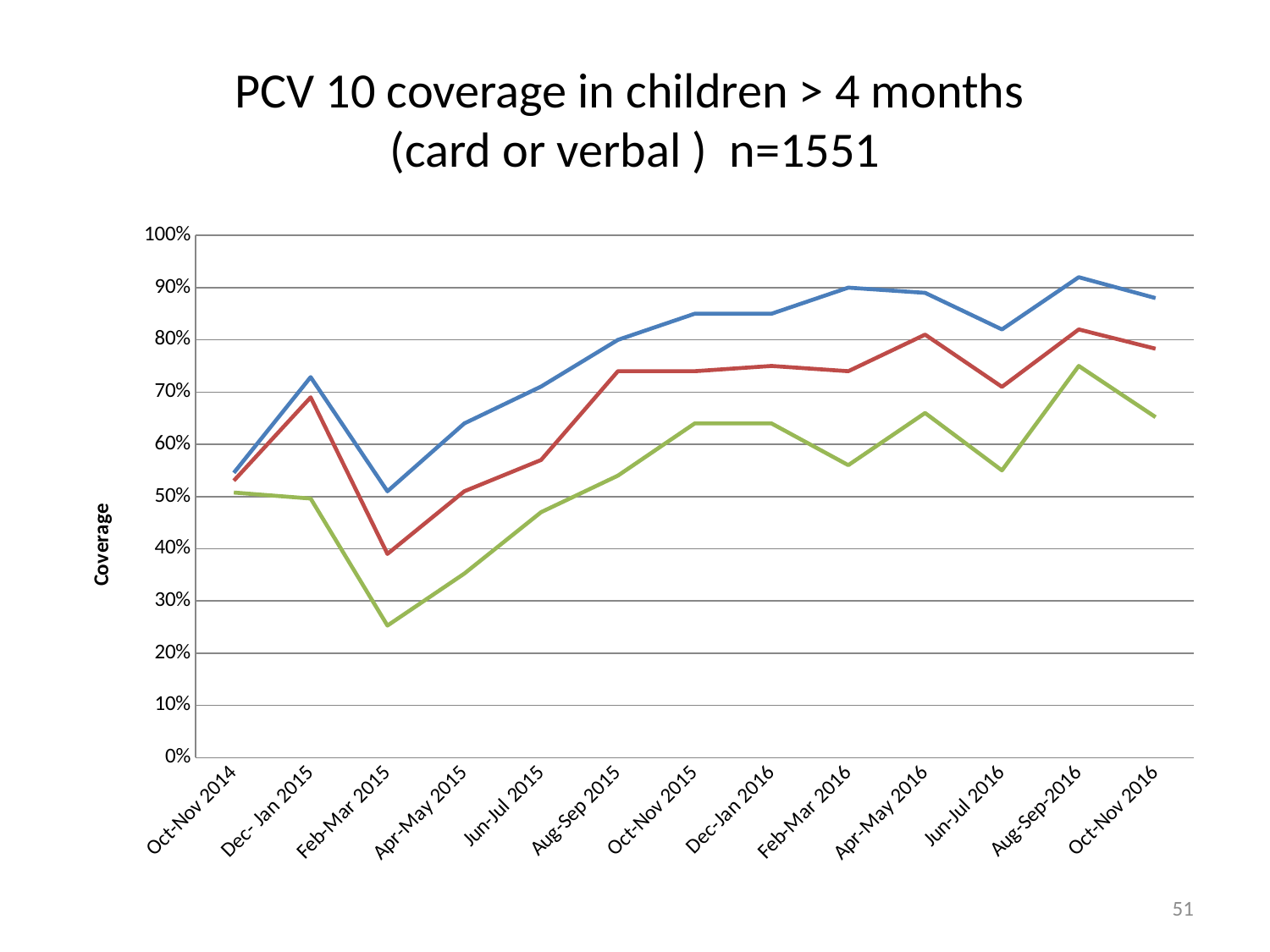
Is the value of the blue line for Feb-Mar 2015 greater or less than 60%? less What kind of chart is shown on the slide? line chart What is the title of the chart? PCV 10 coverage in children > 4 months (card or verbal ) n=1551 Is the value of the blue line for Aug-Sep-2016 greater or less than 80%? greater Is the value of the green line for Feb-Mar 2015 greater or less than 30%? less What is the label on the vertical axis of the chart? Coverage How many time periods are shown along the x axis of the chart? 13 How many lines are plotted on the chart? 3 In which period does the green line reach its lowest value? Feb-Mar 2015 In which period does the red line reach its lowest value? Feb-Mar 2015